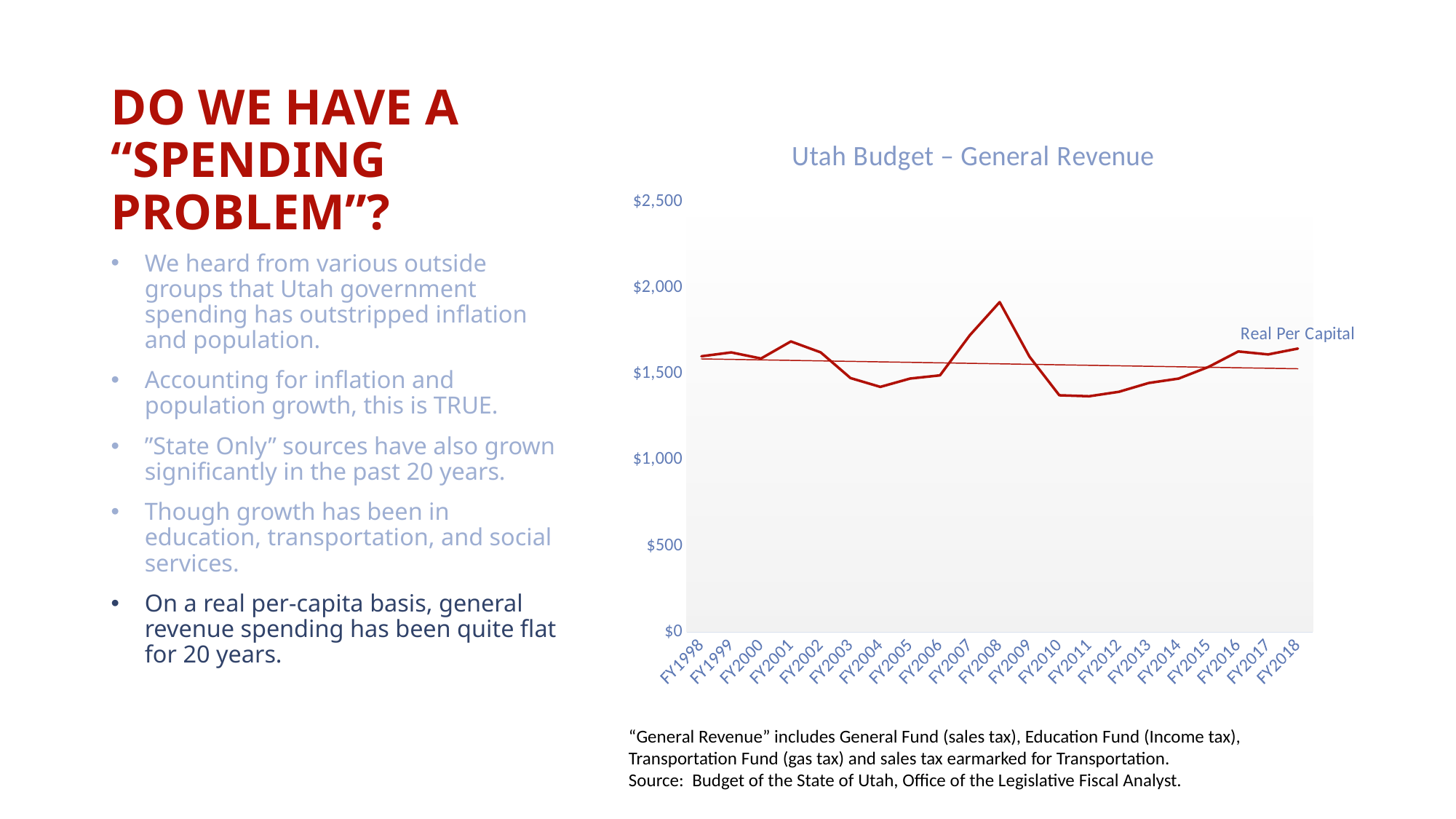
Which fiscal year has the larger value, FY2001 or FY2004? FY2001 Is the value for FY2010 greater or less than $1,500? less Is the value for FY2018 greater or less than $1,500? greater What is the highest value shown on the y axis of the chart? $2,500 Is the value for FY2004 greater or less than $1,500? less In which fiscal year does the Real Per Capital line reach its highest value? FY2008 Does the line rise or fall between FY2008 and FY2010? fall How many fiscal years are plotted along the x axis of the chart? 21 What kind of chart is shown on the slide? Line chart What is the title of the chart? Utah Budget – General Revenue Which fiscal year has the larger value, FY2008 or FY2010? FY2008